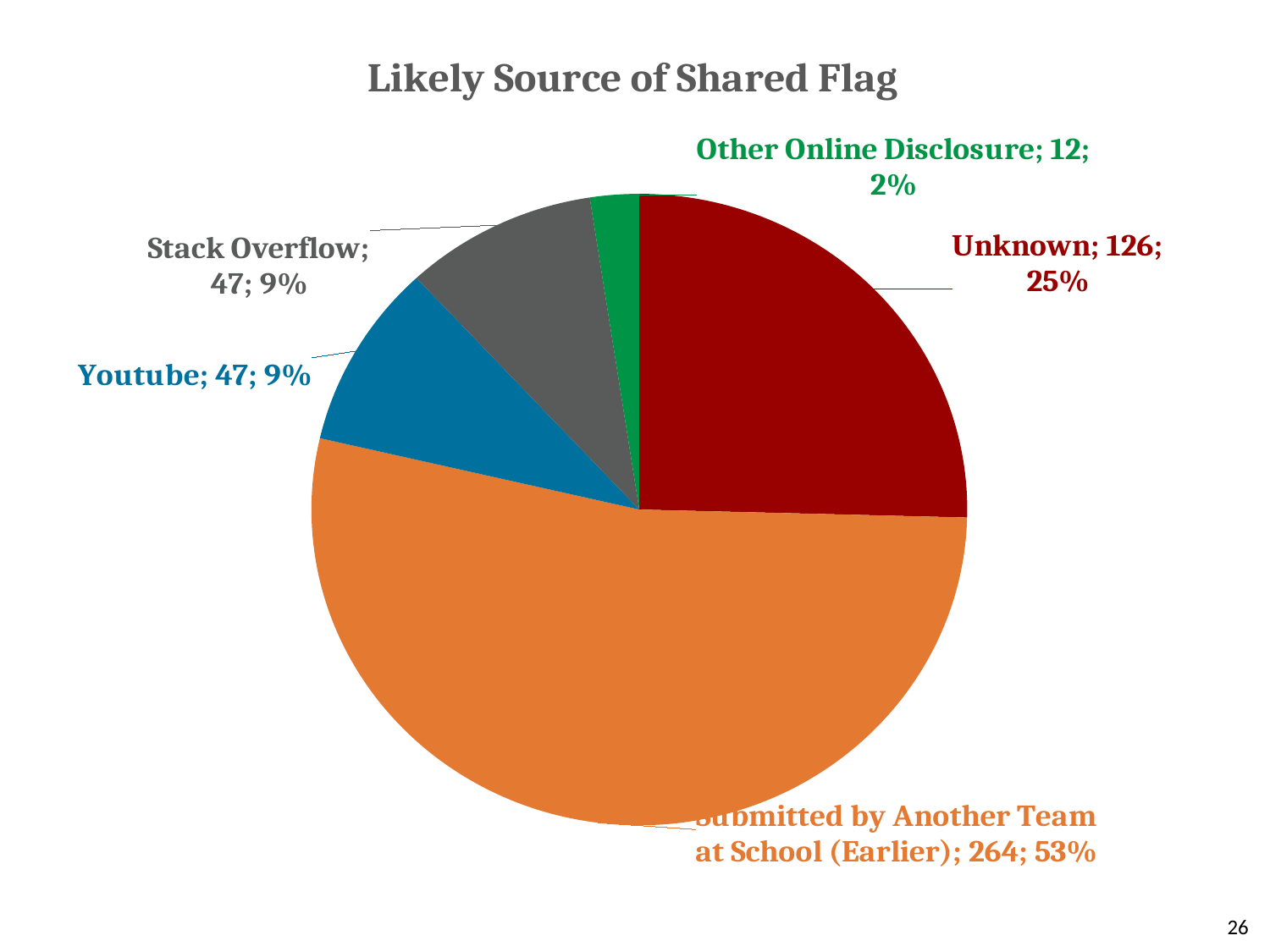
What is the value for Youtube? 47 Which category has the largest slice? Submitted by Another Team at School (Earlier) Which is larger, the value for Unknown or the value for Stack Overflow? Unknown What share of the pie does Unknown represent? 25% What is the value for Other Online Disclosure? 12 What share of the pie does Stack Overflow represent? 9% What is the value for Submitted by Another Team at School (Earlier)? 264 How many categories are shown in the pie chart? 5 What is the value for Unknown? 126 What kind of chart is shown on the slide? Pie chart Which category has the smallest slice? Other Online Disclosure What is the difference between the values for Submitted by Another Team at School (Earlier) and Unknown? 138